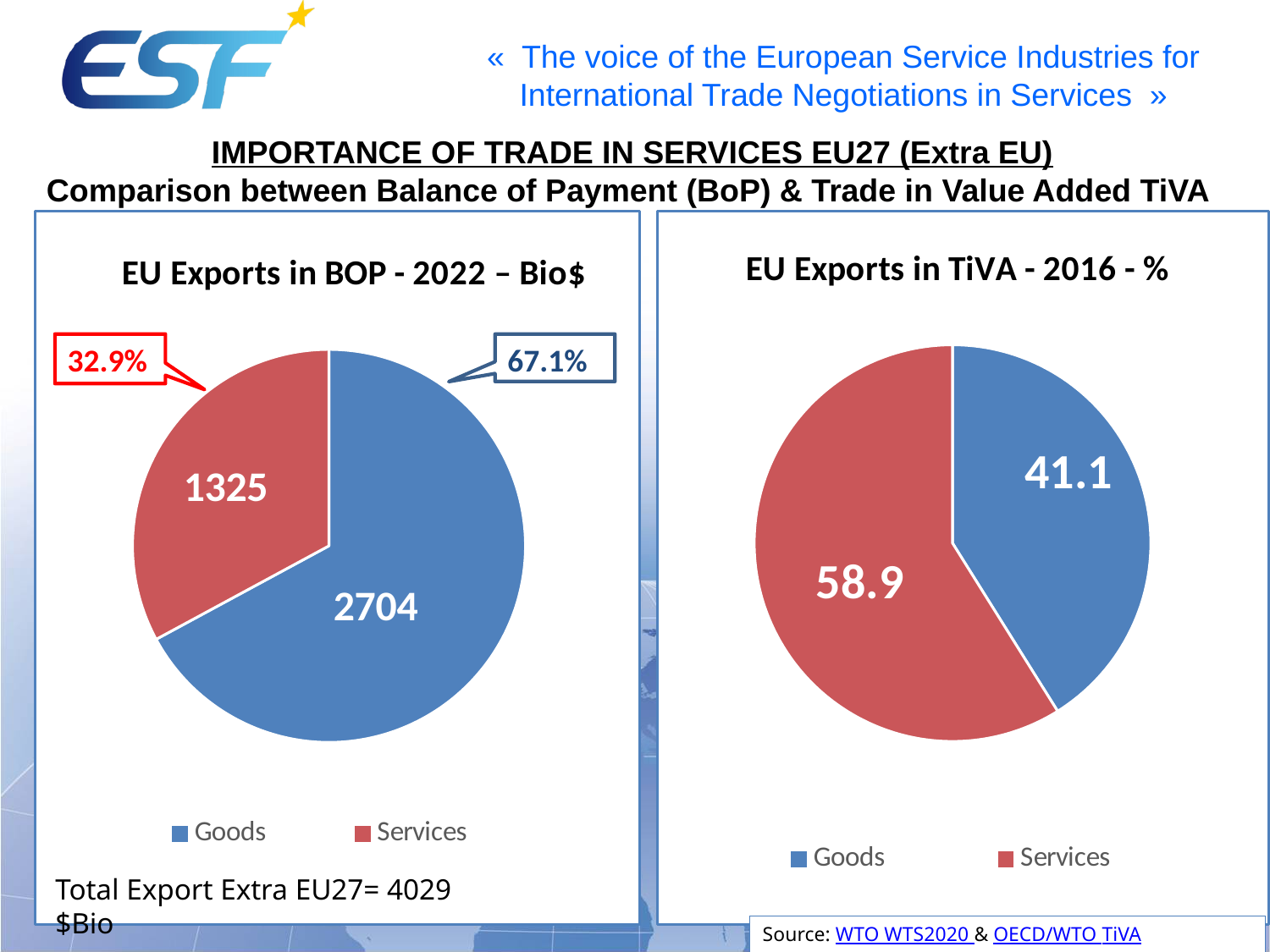
In the 'EU Exports in TiVA - 2016 - %' chart, which category has the smallest slice? Goods In the 'EU Exports in BOP - 2022 – Bio$' chart, what is the difference between the Goods and Services values? 1379 In the 'EU Exports in BOP - 2022 – Bio$' chart, what is the value for Goods? 2704 In the 'EU Exports in BOP - 2022 – Bio$' chart, what is the value for Services? 1325 In the 'EU Exports in BOP - 2022 – Bio$' chart, what share of the pie does Services represent? 32.9% In the 'EU Exports in BOP - 2022 – Bio$' chart, which category has the largest slice? Goods How many categories does the legend of the 'EU Exports in BOP - 2022 – Bio$' chart list? 2 In the 'EU Exports in TiVA - 2016 - %' chart, what is the value for Goods? 41.1 What type of chart is the 'EU Exports in TiVA - 2016 - %' chart? Pie chart In the 'EU Exports in BOP - 2022 – Bio$' chart, what share of the pie does Goods represent? 67.1% In the 'EU Exports in TiVA - 2016 - %' chart, is the value for Services larger or smaller than the value for Goods? larger In the 'EU Exports in TiVA - 2016 - %' chart, what is the value for Services? 58.9